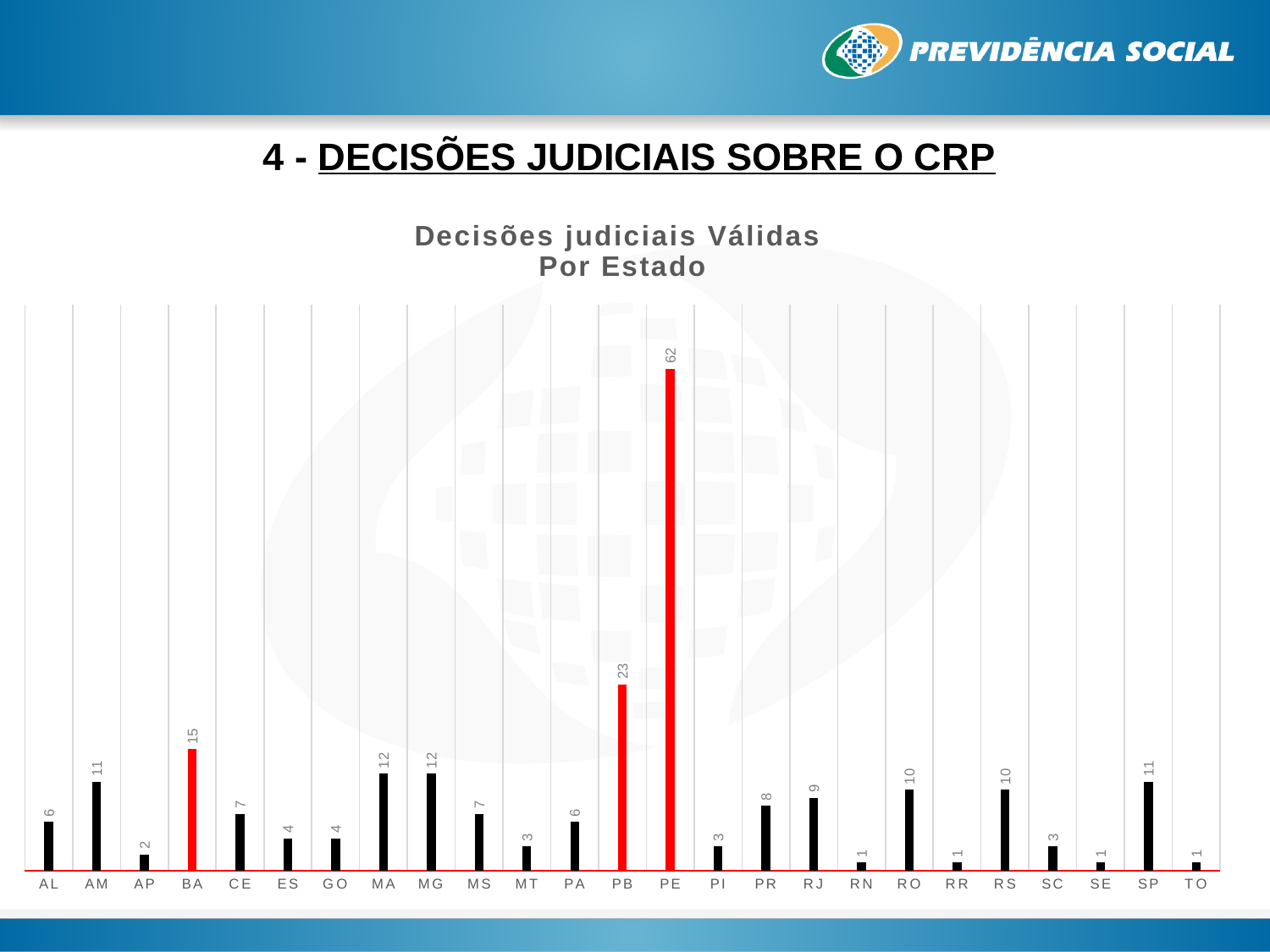
Which state has the highest value? PE What is the difference between the values for BA and AM? 4 What is the difference between the values for PE and PB? 39 What is the value for BA? 15 What is the value for RJ? 9 What is the value for PB? 23 What is the value for PE? 62 Which has a larger value, RO or PR? RO Which has a larger value, PB or BA? PB What kind of chart is shown? Bar chart Which states are shown with red bars? BA, PB and PE How many states are shown on the x axis? 25